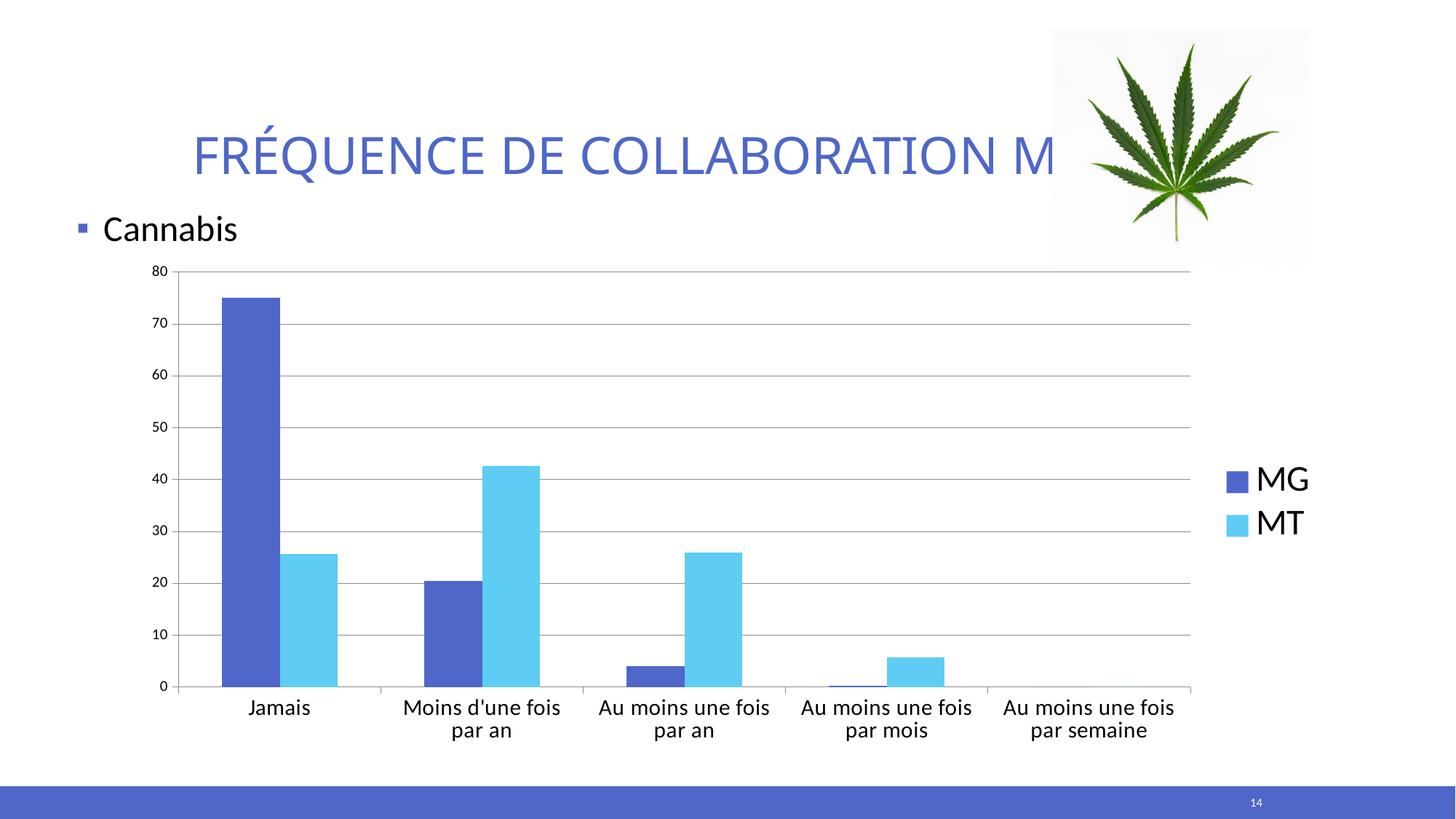
How many categories are shown on the x axis? 5 What kind of chart is shown on the slide? bar chart Which category has the highest value for the MG series? Jamais How many series does the legend list? 2 Is the MG value for Jamais greater or less than 70? greater For the category Jamais, which series has the larger value, MG or MT? MG Which category has the highest value for the MT series? Moins d'une fois par an What are the two entries listed in the legend? MG and MT For the category Moins d'une fois par an, which series has the larger value, MG or MT? MT Is the MT value for Jamais greater or less than 30? less Is the MG value for Au moins une fois par an greater or less than 10? less Do the MG values rise or fall moving from left to right along the x axis? fall